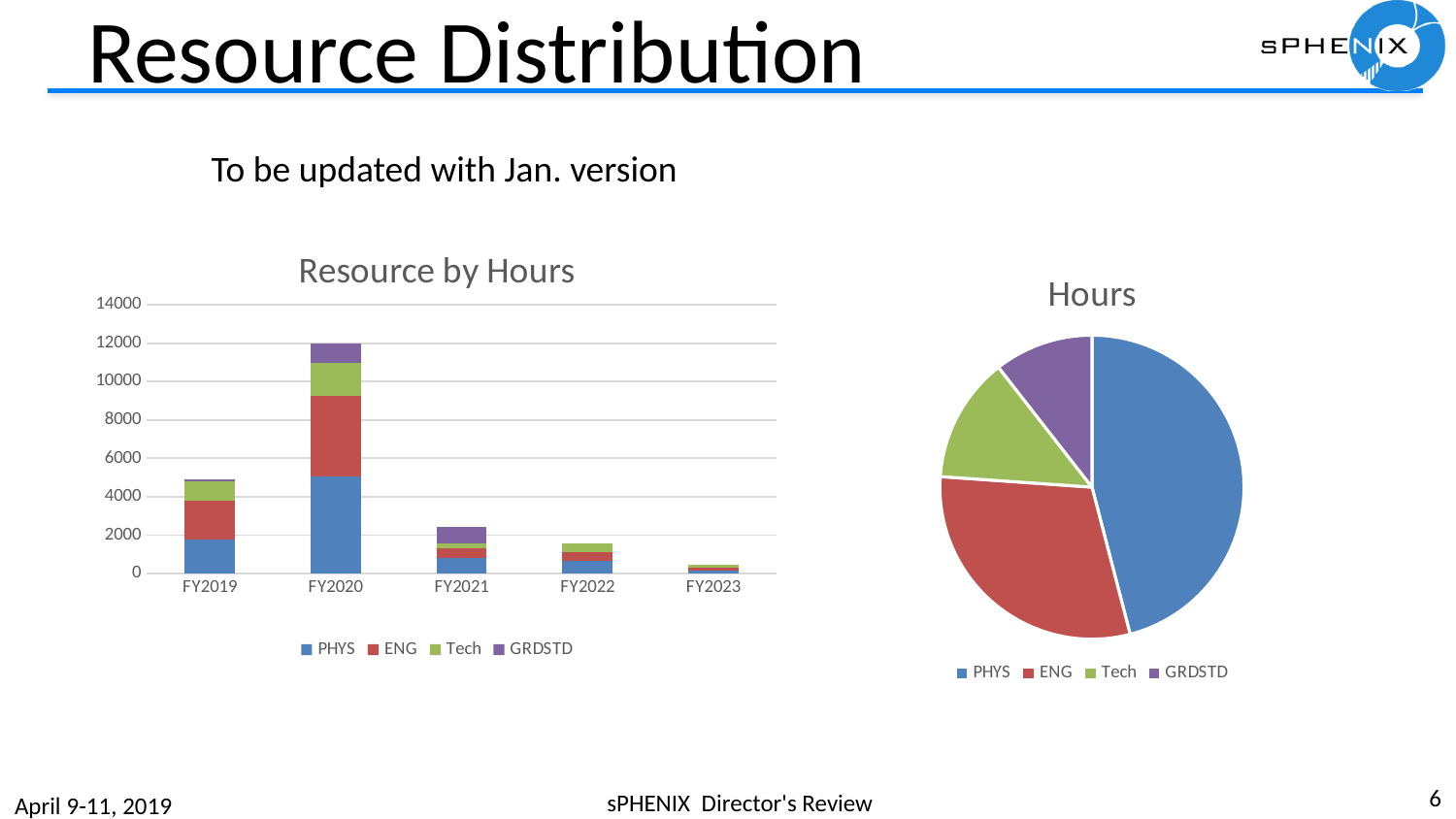
What kind of chart is the 'Resource by Hours' chart? stacked bar chart In the 'Resource by Hours' chart, is the total for FY2023 greater or less than 2000? less In the 'Resource by Hours' chart, is the total for FY2020 greater or less than 10000? greater In the 'Resource by Hours' chart, do the stacked bar totals rise or fall from FY2020 to FY2023? fall In the 'Resource by Hours' chart, how many fiscal years are shown on the x axis? 5 In the 'Hours' pie chart, which category has the largest slice? PHYS How many series does the legend of the 'Resource by Hours' chart list? 4 What kind of chart is the 'Hours' chart on the right? pie chart In the 'Resource by Hours' chart, which fiscal year has the tallest stacked bar? FY2020 In the 'Hours' pie chart, which slice is larger, PHYS or ENG? PHYS In the 'Resource by Hours' chart, is the total for FY2019 greater or less than 6000? less In the 'Resource by Hours' chart, which fiscal year has the shortest stacked bar? FY2023